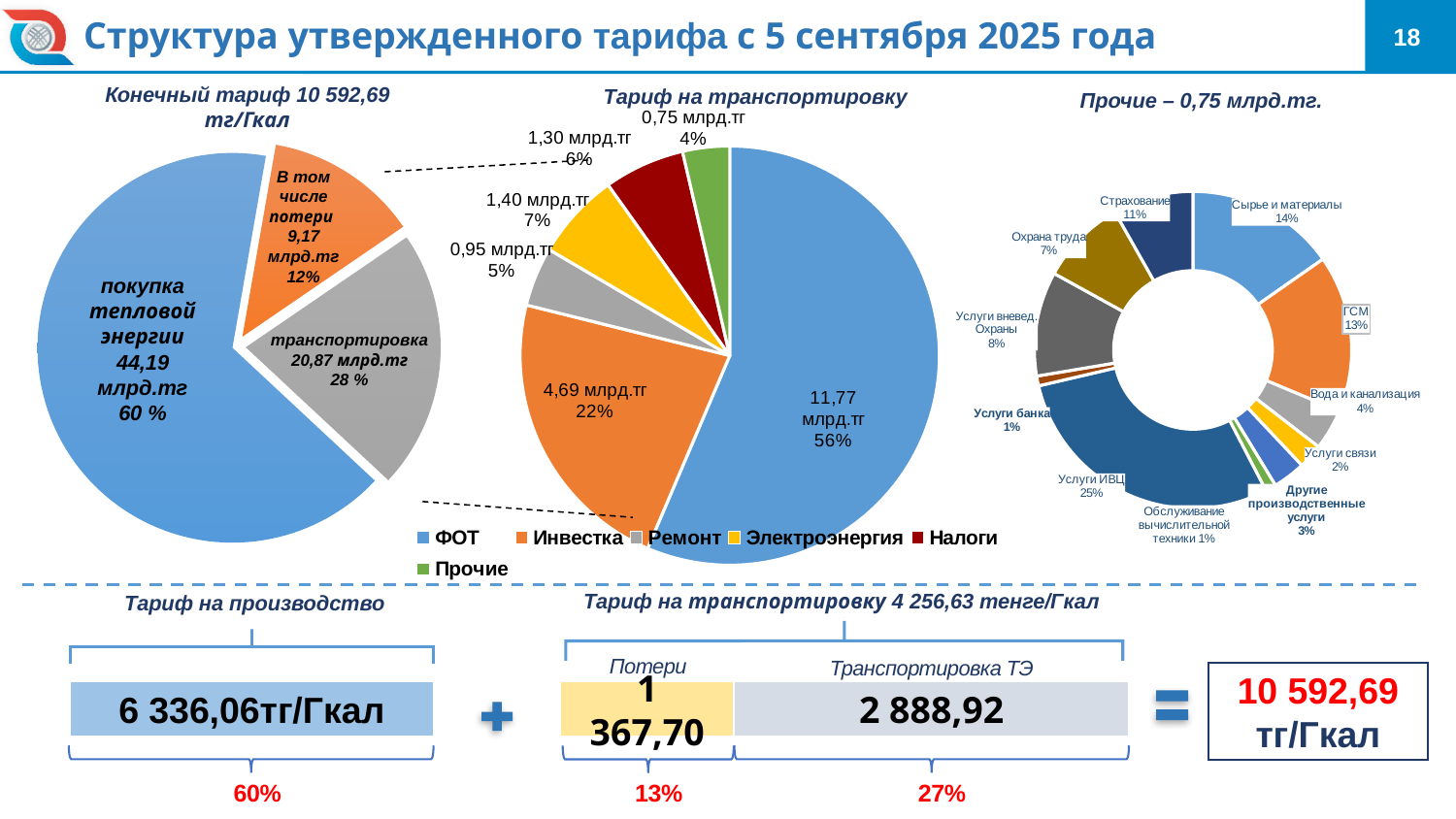
How many entries does the legend of the middle pie chart (Тариф на транспортировку) list? 6 In the middle pie chart (Тариф на транспортировку), what is the difference between Инвестка and Ремонт in млрд.тг? 3,74 млрд.тг In the right doughnut chart (Прочие – 0,75 млрд.тг), what share does Услуги ИВЦ have? 25% In the middle pie chart (Тариф на транспортировку), what is the value for ФОТ? 11,77 млрд.тг In the left pie chart (Конечный тариф), what is the value of потери? 9,17 млрд.тг In the middle pie chart (Тариф на транспортировку), which category has the smallest share? Прочие In the left pie chart (Конечный тариф), what is the value for транспортировка? 20,87 млрд.тг In the right doughnut chart (Прочие – 0,75 млрд.тг), which category has the largest share? Услуги ИВЦ In the middle pie chart (Тариф на транспортировку), which category has the largest share? ФОТ In the middle pie chart (Тариф на транспортировку), which is larger: Электроэнергия or Налоги? Электроэнергия In the left pie chart (Конечный тариф), what share does покупка тепловой энергии have? 60 % What type of chart is the right chart titled Прочие – 0,75 млрд.тг? Doughnut chart